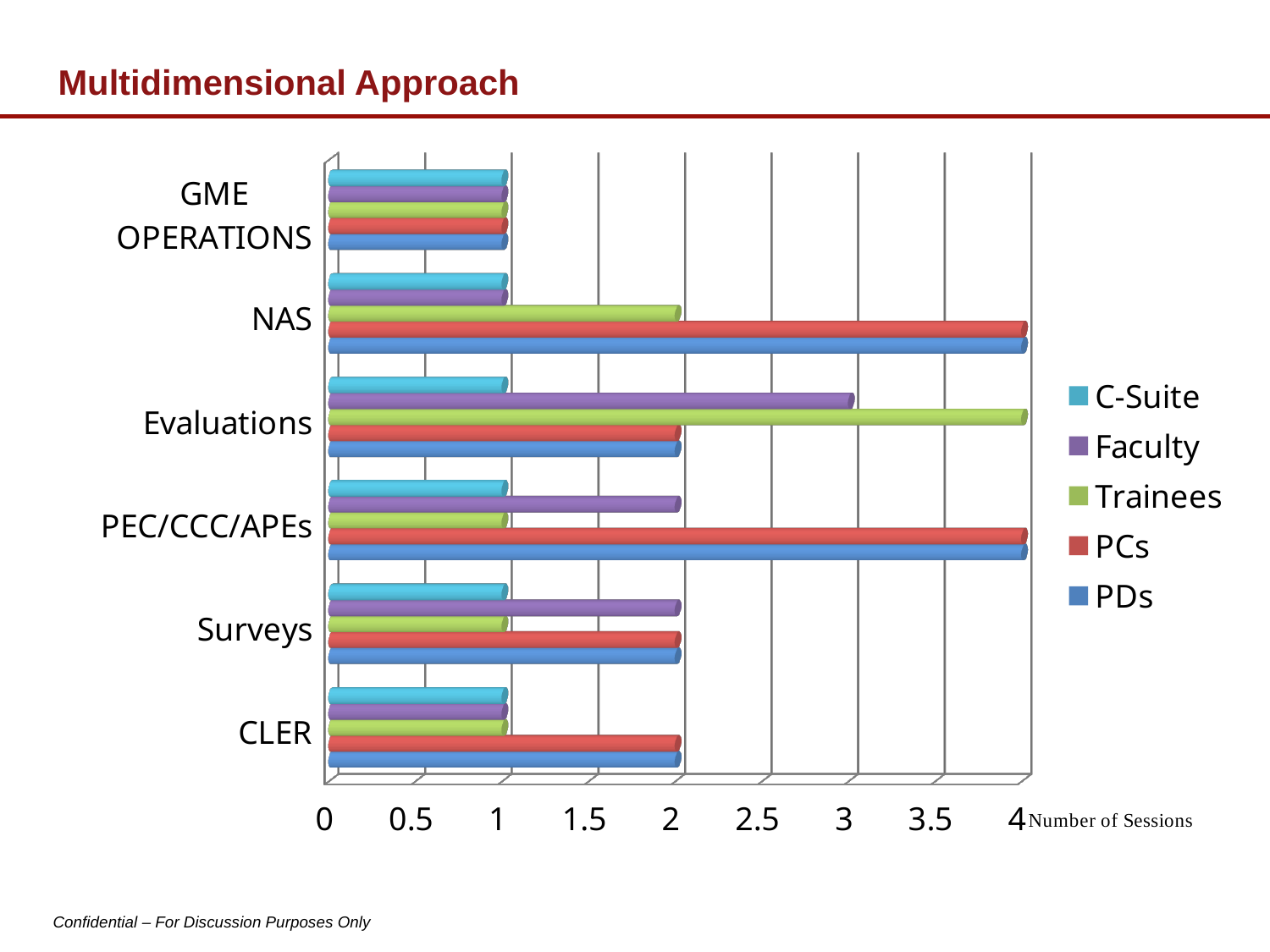
What is the number of sessions for PCs in the CLER category? 2 What is the number of sessions for Faculty in the Evaluations category? 3 What is the difference between the PCs and Trainees values in the PEC/CCC/APEs category? 3 What is the label on the horizontal axis? Number of Sessions How many categories are shown on the vertical axis? 6 Which is larger in the Surveys category, the Faculty value or the Trainees value? Faculty How many series does the legend list? 5 What is the number of sessions for Trainees in the Evaluations category? 4 Which series has the highest number of sessions in the Evaluations category? Trainees What is the number of sessions for PDs in the NAS category? 4 What kind of chart is shown on the slide? bar chart